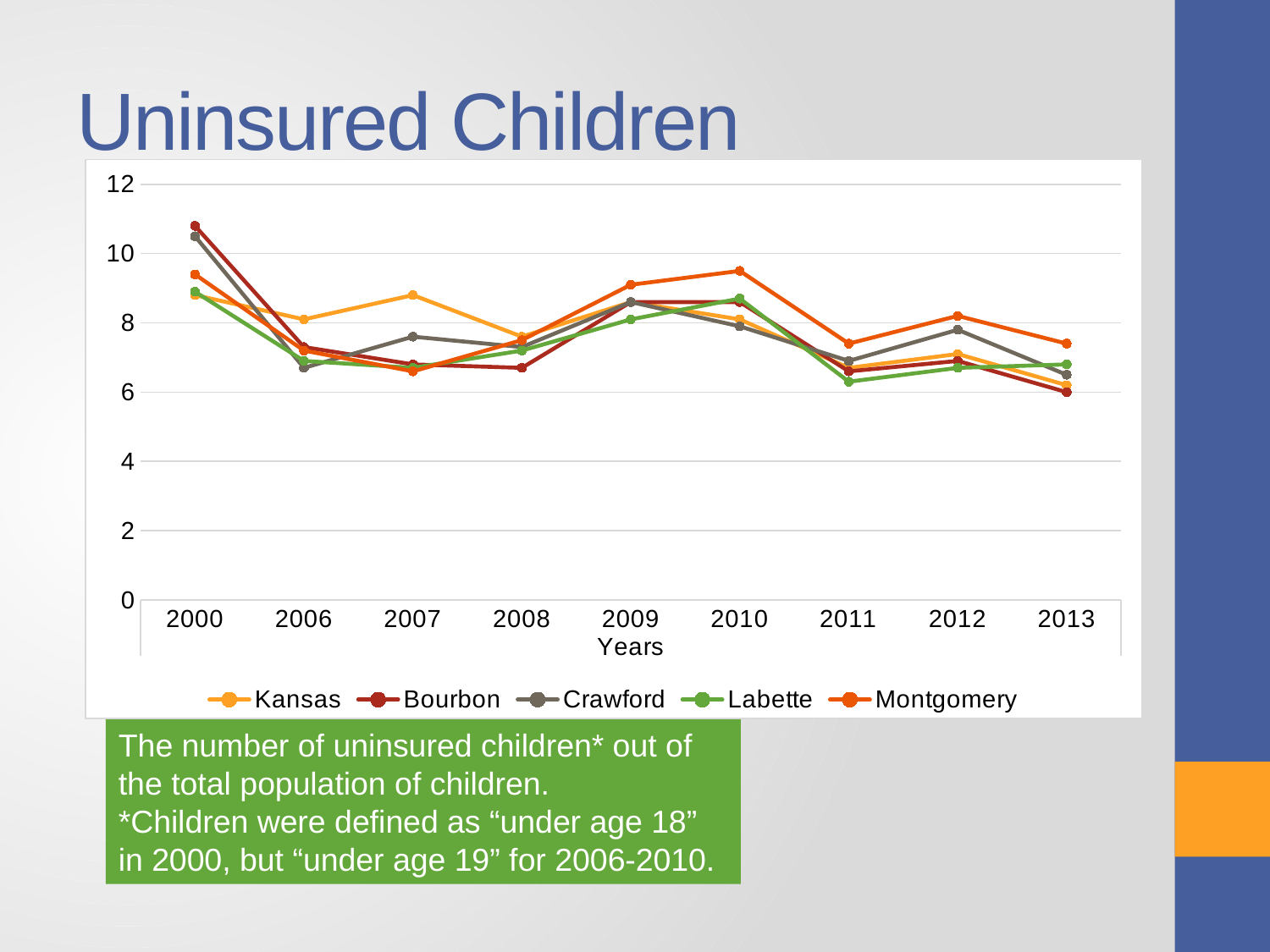
Is the value for Bourbon in 2000 greater or less than 10? greater Which is larger in 2007, the value for Kansas or the value for Bourbon? Kansas What kind of chart is shown on the slide? line chart How many years are plotted along the x axis? 9 What is the label of the x axis? Years What is the title of the chart? Uninsured Children How many series does the legend list? 5 Is the value for Labette in 2011 greater or less than 8? less In which year is the value for Bourbon highest? 2000 Which series has the highest value in 2010? Montgomery Is the value for Montgomery in 2010 greater or less than 8? greater